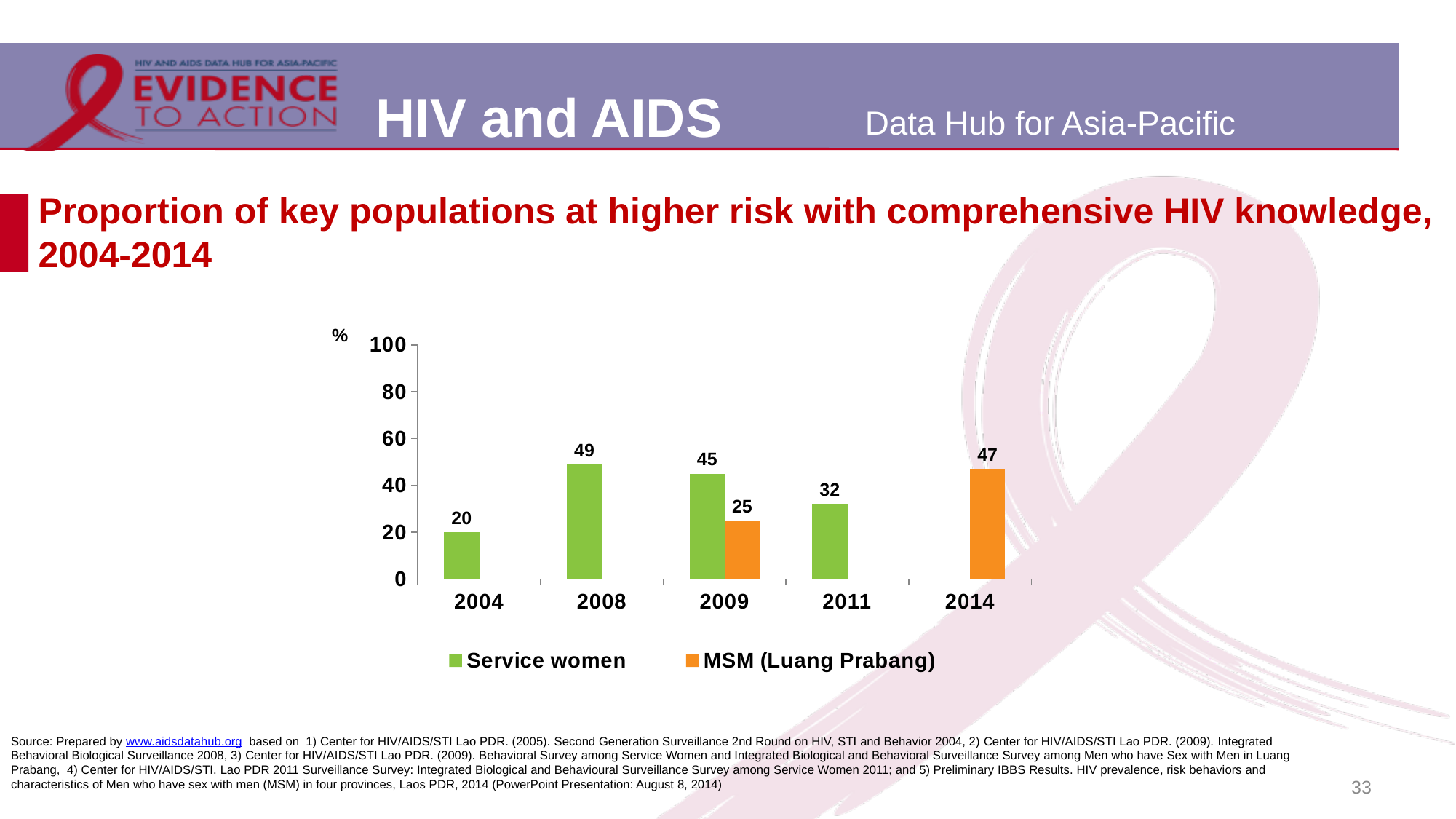
What is the value for MSM (Luang Prabang) in 2009? 25 What colour are the bars for MSM (Luang Prabang)? Orange How many series does the legend list? 2 In which year is the Service women value highest? 2008 How many years are shown on the x axis? 5 What is the value for Service women in 2004? 20 What is the value for MSM (Luang Prabang) in 2014? 47 Which is larger in 2009, the Service women value or the MSM (Luang Prabang) value? Service women What is the value for Service women in 2008? 49 In which year is the Service women value lowest? 2004 What is the difference between the Service women and MSM (Luang Prabang) values in 2009? 20 What kind of chart is shown on the slide? Bar chart